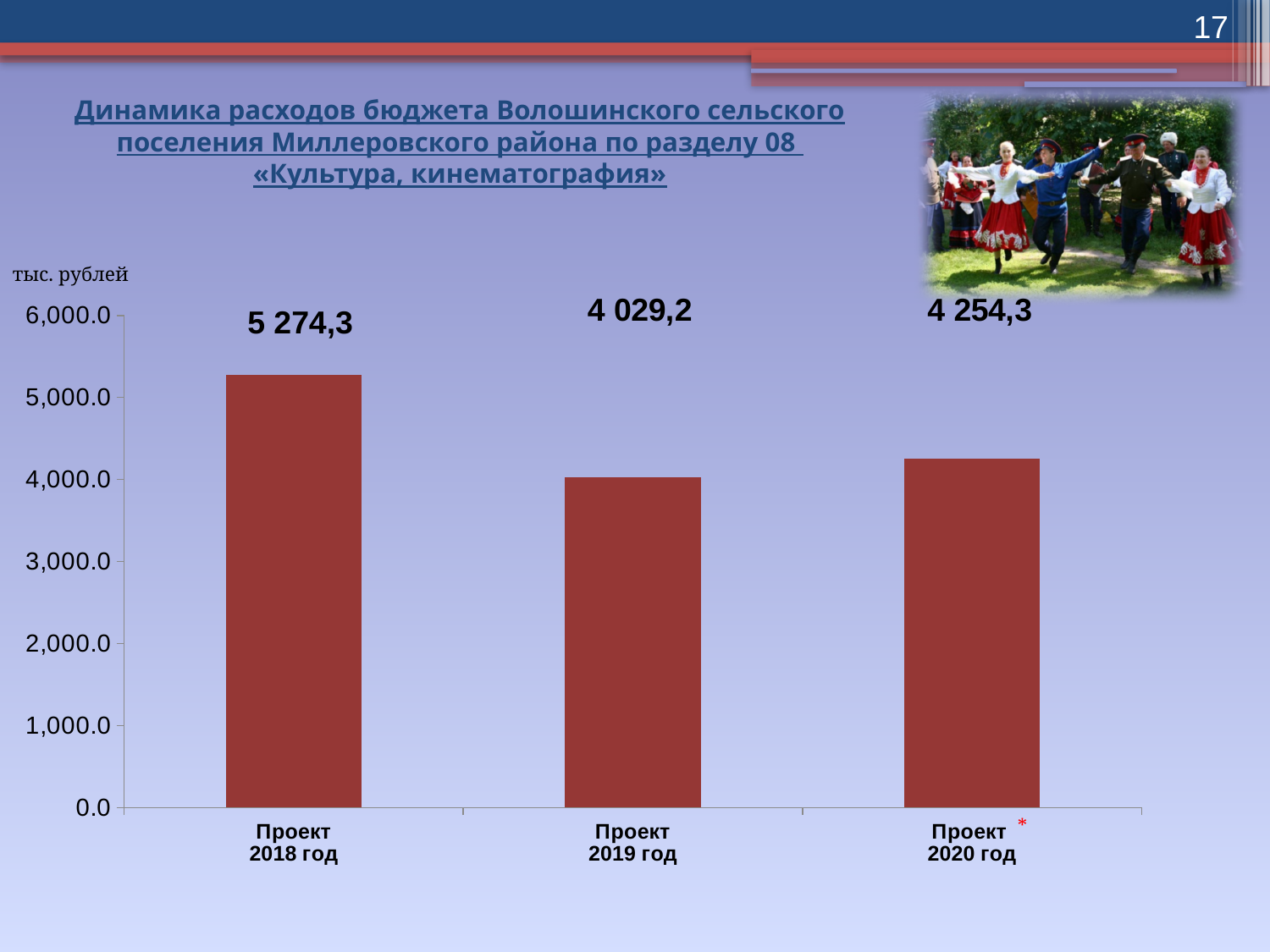
What is the difference between the values for Проект 2020 год and Проект 2019 год? 225,1 What is the difference between the values for Проект 2018 год and Проект 2019 год? 1 245,1 Which category has the lowest value? Проект 2019 год In what units are the values on the chart expressed? тыс. рублей Is the value for Проект 2018 год greater or less than 5,000.0? greater How many categories are shown on the chart? 3 Which category has the highest value? Проект 2018 год What is the value for Проект 2018 год? 5 274,3 What is the value for Проект 2020 год? 4 254,3 What kind of chart is shown on the slide? bar chart Which is larger, the value for Проект 2020 год or Проект 2019 год? Проект 2020 год What is the value for Проект 2019 год? 4 029,2